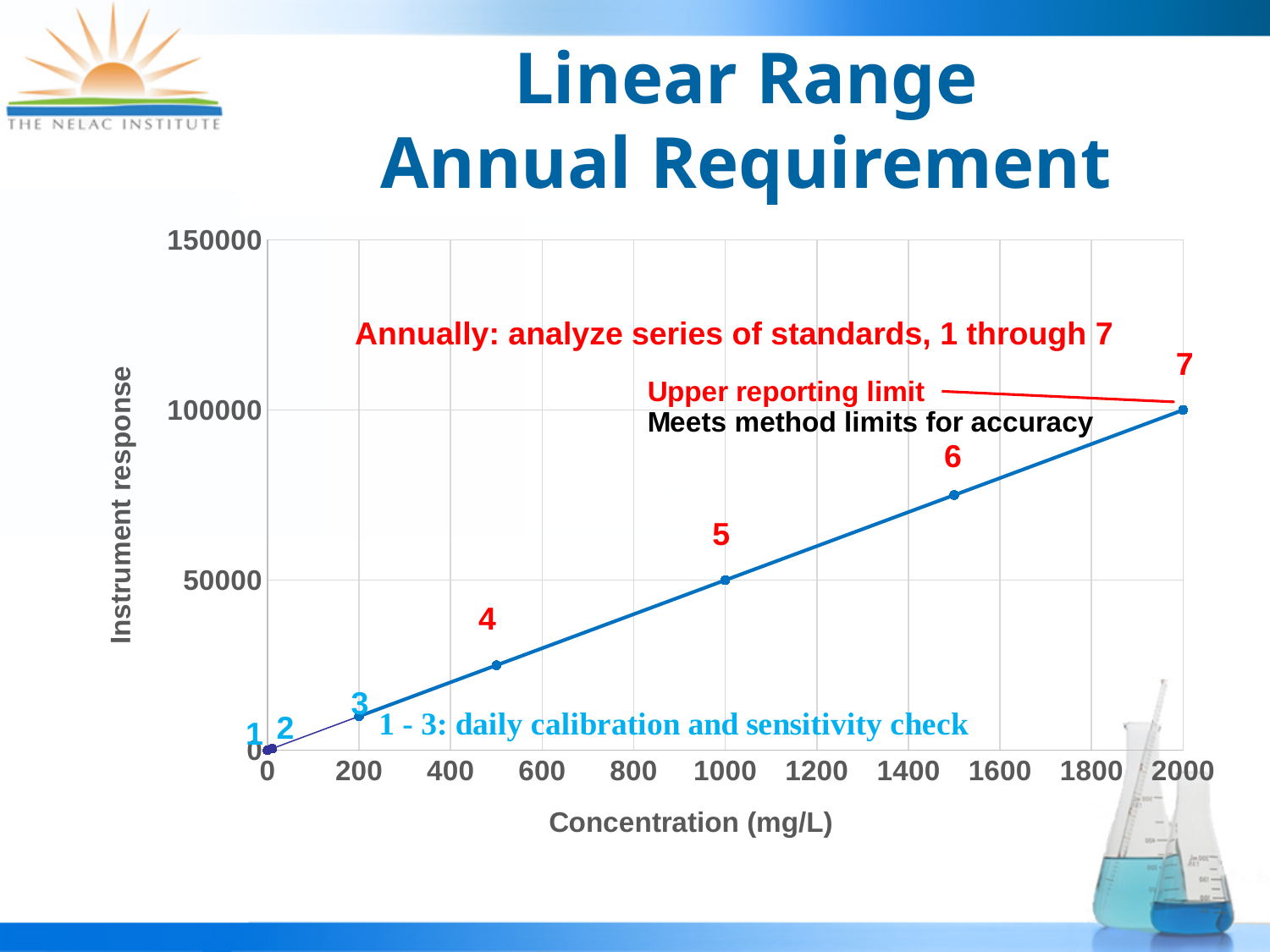
What is the instrument response at a concentration of 1000 mg/L (point 5)? 50000 Which numbered point has the highest instrument response? 7 What is the title of the y axis? Instrument response Is the instrument response for point 6 greater or less than 50000? greater What is the instrument response at a concentration of 2000 mg/L (point 7)? 100000 What is the title of the x axis? Concentration (mg/L) Does the instrument response rise or fall as concentration increases along the x axis? rise How many numbered standard points are plotted on the chart? 7 What kind of chart is shown on the slide? line chart Which numbered point has the lowest instrument response? 1 Which has the larger instrument response, point 3 or point 6? point 6 Is the instrument response for point 4 greater or less than 50000? less